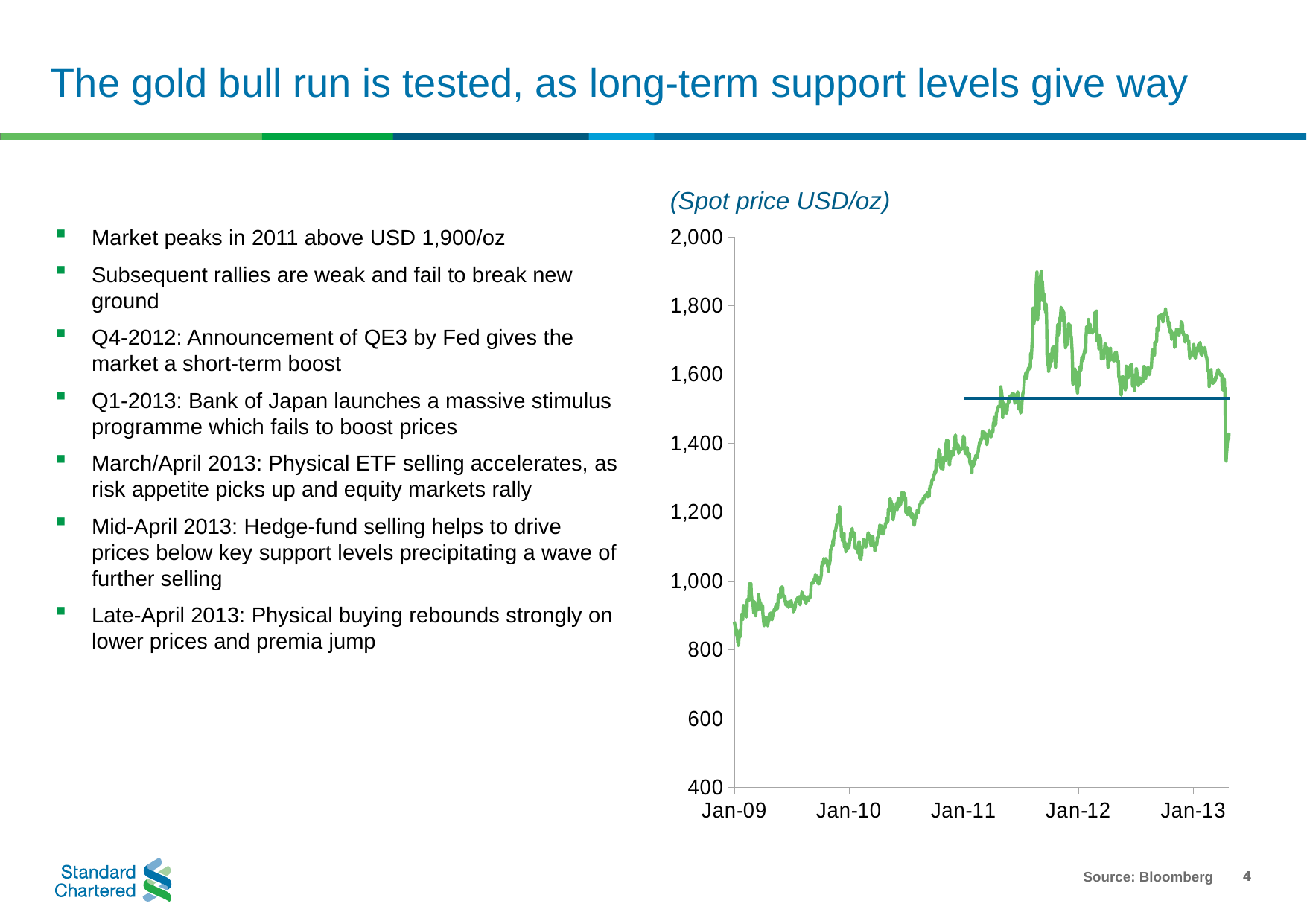
How many labels are shown on the chart's x axis? 5 Is the spot price at Jan-09 greater or less than 1,000? less What kind of chart is shown on the slide? line chart What is the highest value shown on the chart's y axis? 2,000 What is the subtitle printed above the chart? (Spot price USD/oz) Is the spot price at Jan-10 greater or less than 1,000? greater Is the spot price at the end of the line (after Jan-13) greater or less than 1,600? less Does the spot price rise or fall from Jan-13 to the end of the line? fall Does the spot price rise or fall between Jan-09 and Jan-11? rise Does the line reach its highest point before or after Jan-12? before